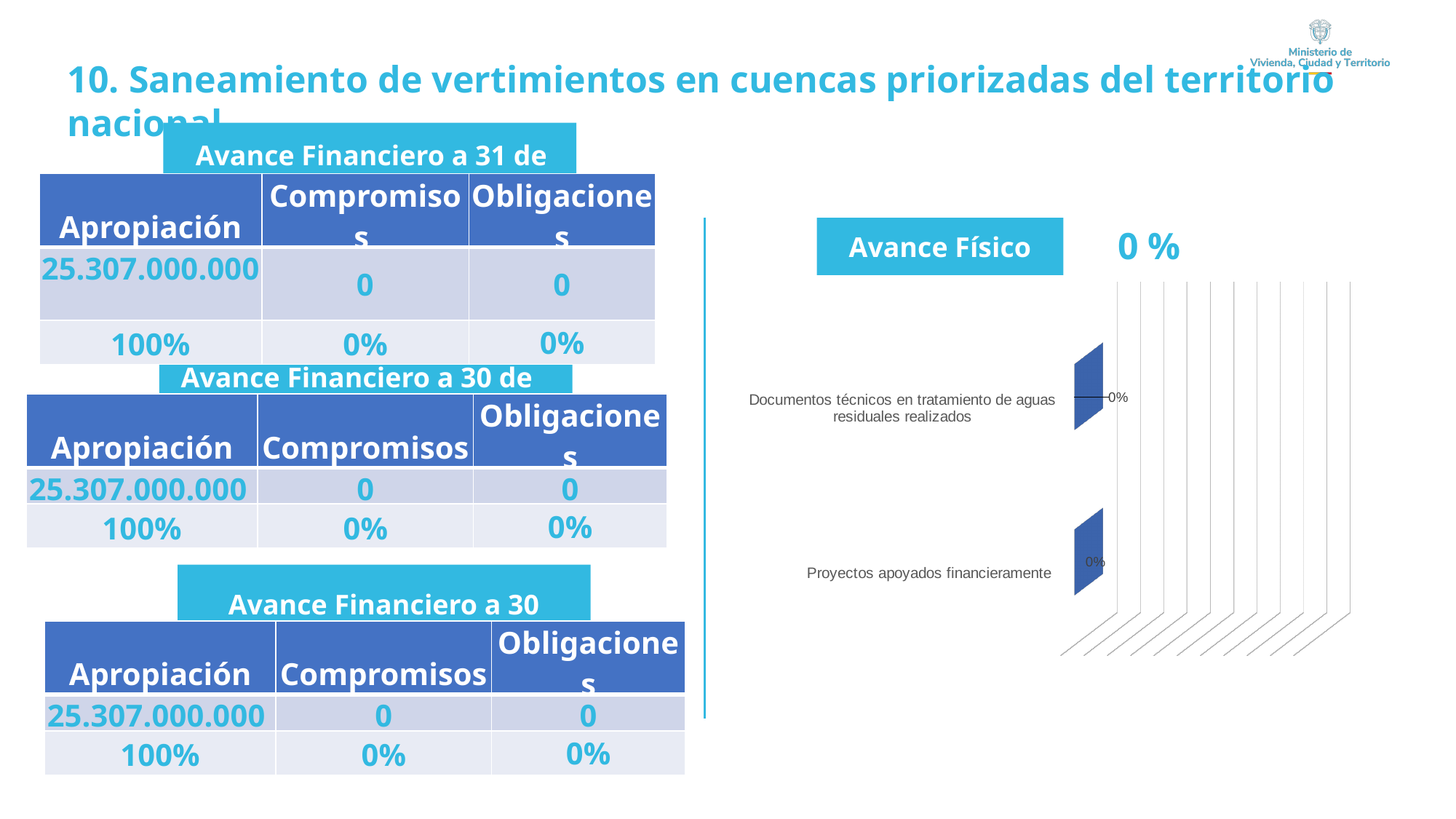
What kind of chart is the Avance Físico chart? bar chart How many categories are plotted in the Avance Físico chart? 2 What is the value for 'Documentos técnicos en tratamiento de aguas residuales realizados' in the Avance Físico chart? 0% What is the title shown above the bar chart on the right of the slide? Avance Físico What is the difference between the values for 'Documentos técnicos en tratamiento de aguas residuales realizados' and 'Proyectos apoyados financieramente' in the Avance Físico chart? 0% What is the value for 'Proyectos apoyados financieramente' in the Avance Físico chart? 0% What overall percentage is displayed next to the Avance Físico title? 0 %